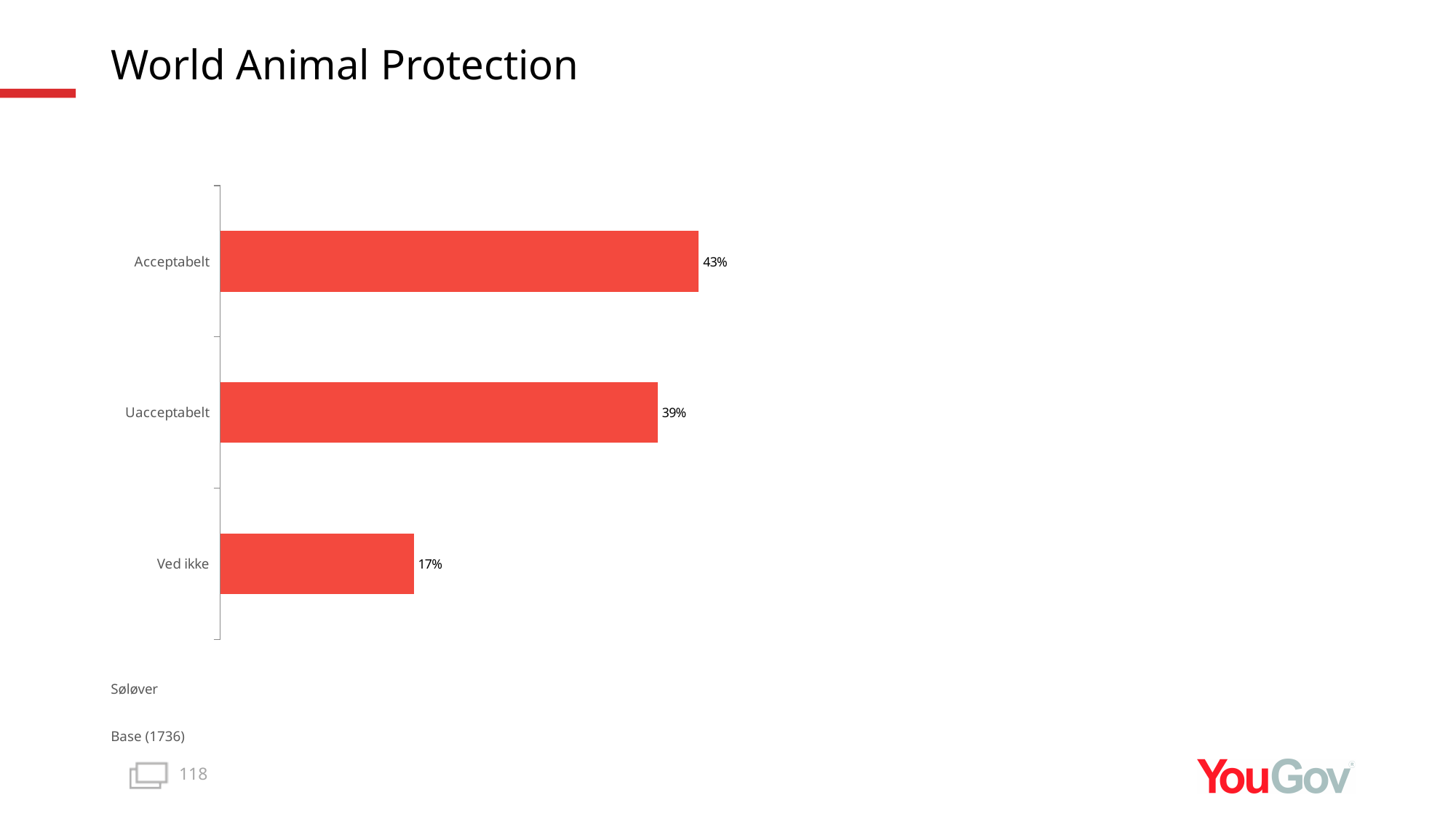
What percentage of respondents answered "Acceptabelt"? 43% What is the base (number of respondents) stated below the chart? 1736 Which response category has the lowest percentage? Ved ikke What is the title of the slide? World Animal Protection What percentage of respondents answered "Uacceptabelt"? 39% Which response category has the highest percentage? Acceptabelt Which is larger, the value for "Acceptabelt" or the value for "Ved ikke"? Acceptabelt What is the difference in percentage points between "Uacceptabelt" and "Ved ikke"? 22 What percentage of respondents answered "Ved ikke"? 17% What type of chart is shown on the slide? Bar chart How many response categories are shown in the chart? 3 What is the difference in percentage points between "Acceptabelt" and "Uacceptabelt"? 4